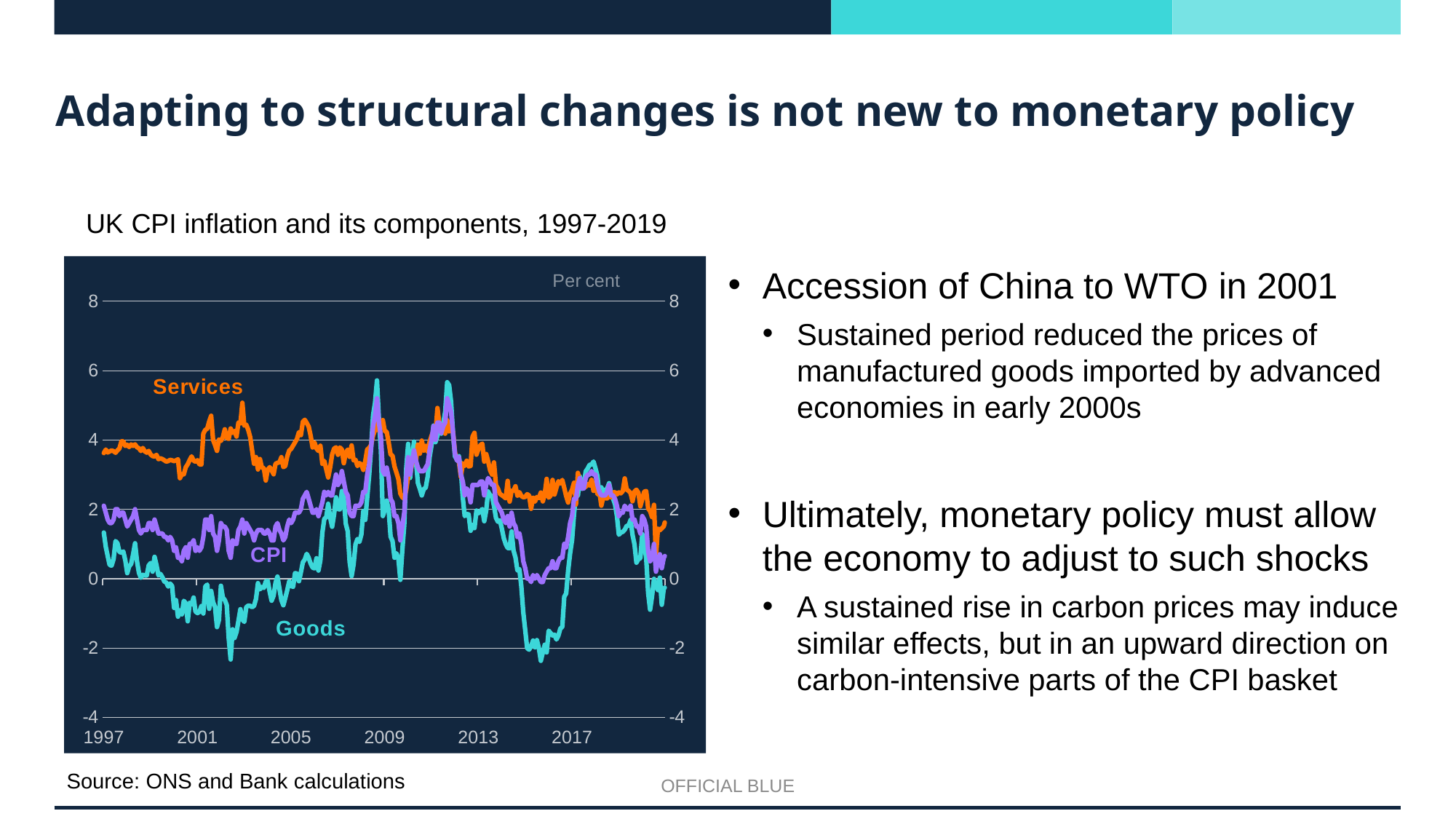
How many year labels are shown on the x axis? 6 Which series has the lowest value at the start of the chart in 1997? Goods Which series has the highest value at the start of the chart in 1997? Services How many series are plotted on the chart? 3 Is the value for Services in 1997 greater or less than 2? greater What is the title of the chart? UK CPI inflation and its components, 1997-2019 Is the value for Goods around 2015 greater or less than 0? less Is the value for Goods around 2003 greater or less than 0? less Which is larger in 1997, the value for Services or the value for Goods? Services What unit is shown on the chart's y axis? Per cent Does the Services series overall rise or fall between 1997 and 2019? fall What kind of chart is shown on the slide? line chart